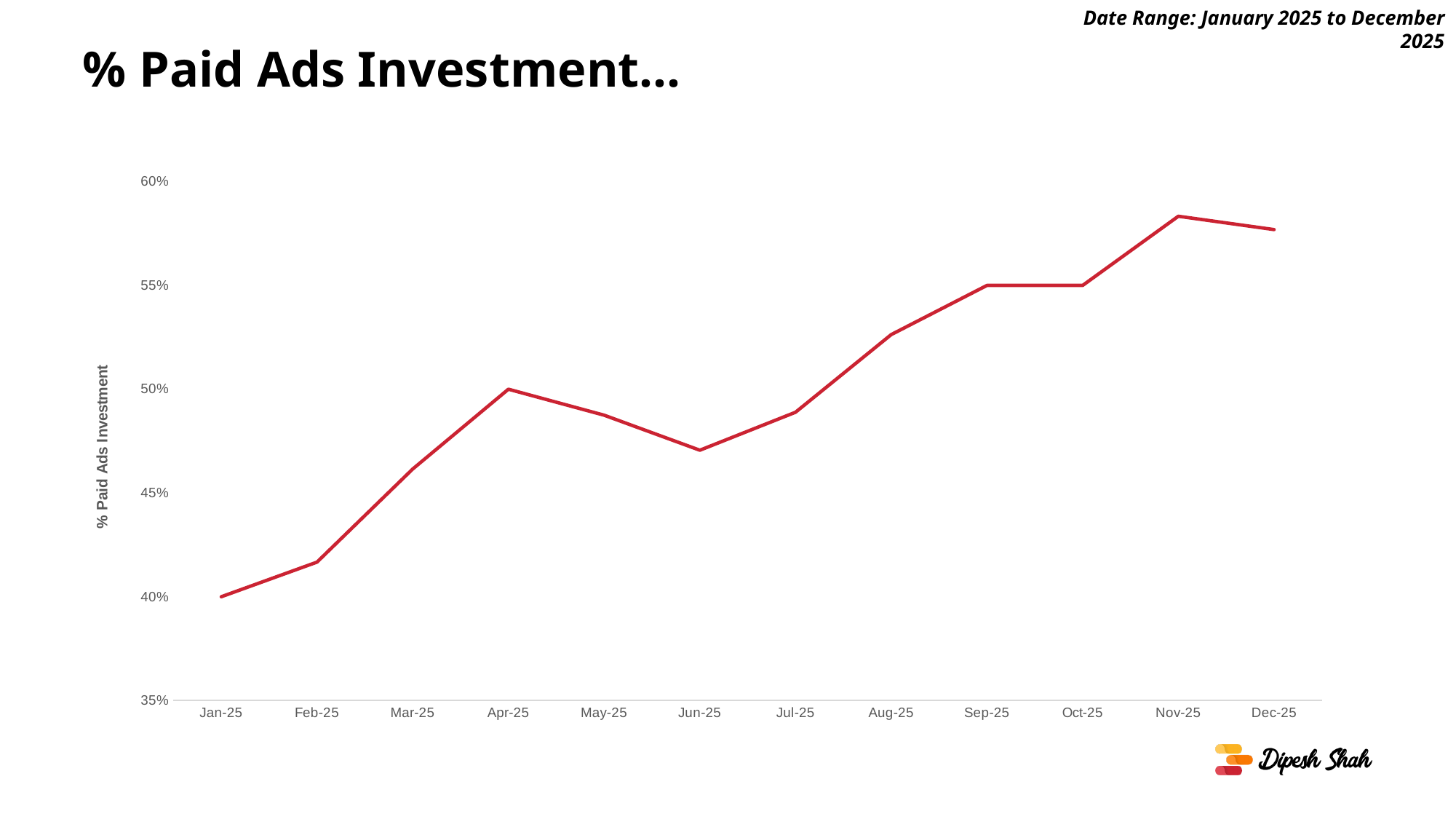
Is the value for Aug-25 greater or less than 50%? greater Which month has the lowest % Paid Ads Investment? Jan-25 What is the % Paid Ads Investment value for Apr-25? 50% What is the % Paid Ads Investment value for Sep-25? 55% By how many percentage points does the value for Apr-25 exceed the value for Jan-25? 10 Is the value for Feb-25 greater or less than 45%? less What kind of chart is shown on the slide? line chart Which month has the highest % Paid Ads Investment? Nov-25 How many months are plotted on the x axis? 12 Is the value for Jun-25 greater or less than 50%? less Does the % Paid Ads Investment generally rise or fall from Jan-25 to Dec-25? rise What is the % Paid Ads Investment value for Jan-25? 40%